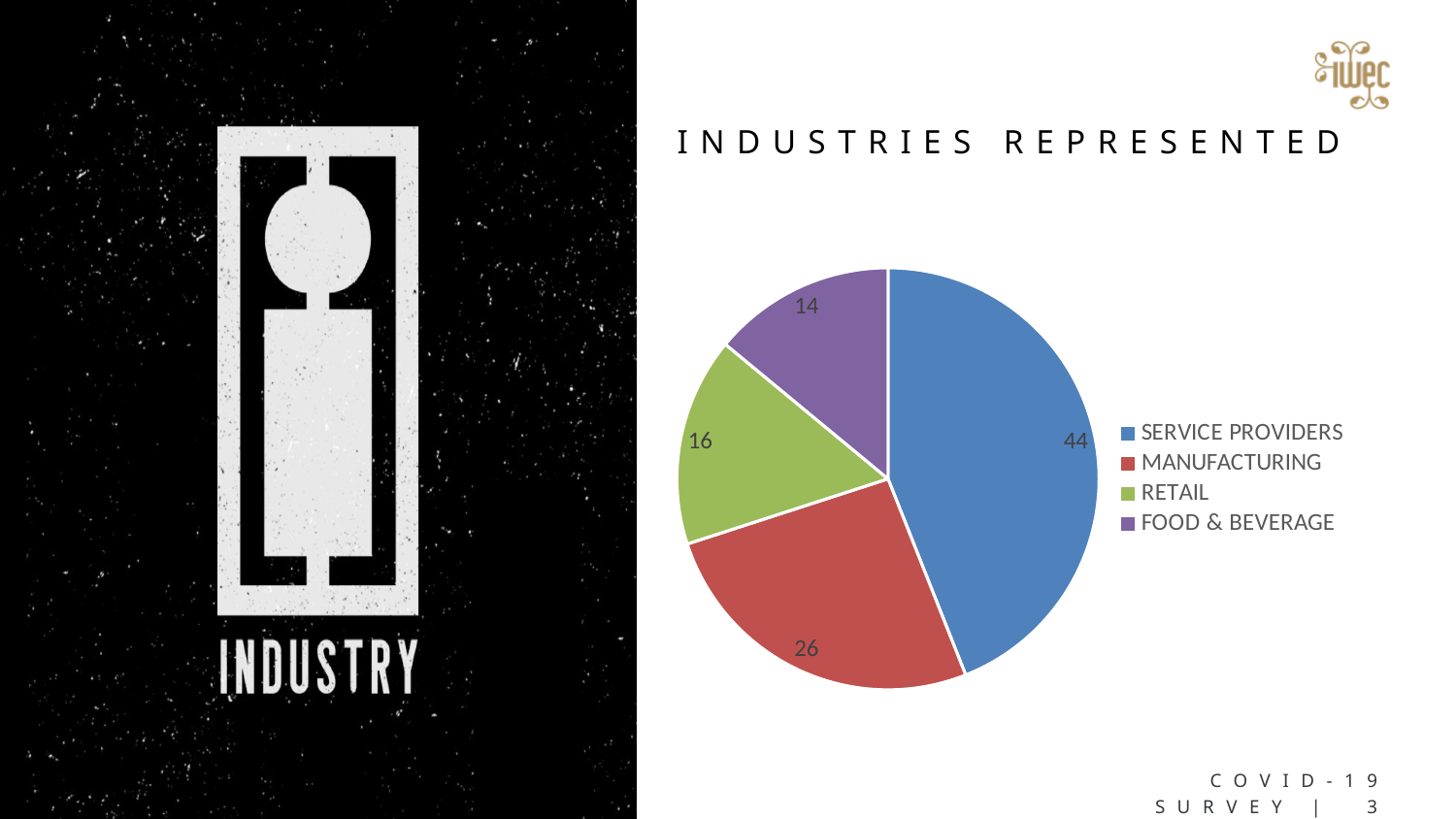
What is the difference between the values for Service Providers and Manufacturing? 18 Which industry has the smallest slice of the pie? Food & Beverage What share of the pie does Service Providers represent? 44% What kind of chart is shown on the slide? pie chart What is the value for Service Providers? 44 Which industry has the largest slice of the pie? Service Providers What is the value for Manufacturing? 26 What is the value for Food & Beverage? 14 What is the title of the chart? INDUSTRIES REPRESENTED How many slices does the pie chart have? 4 What is the value for Retail? 16 Which is larger, the value for Retail or the value for Manufacturing? Manufacturing